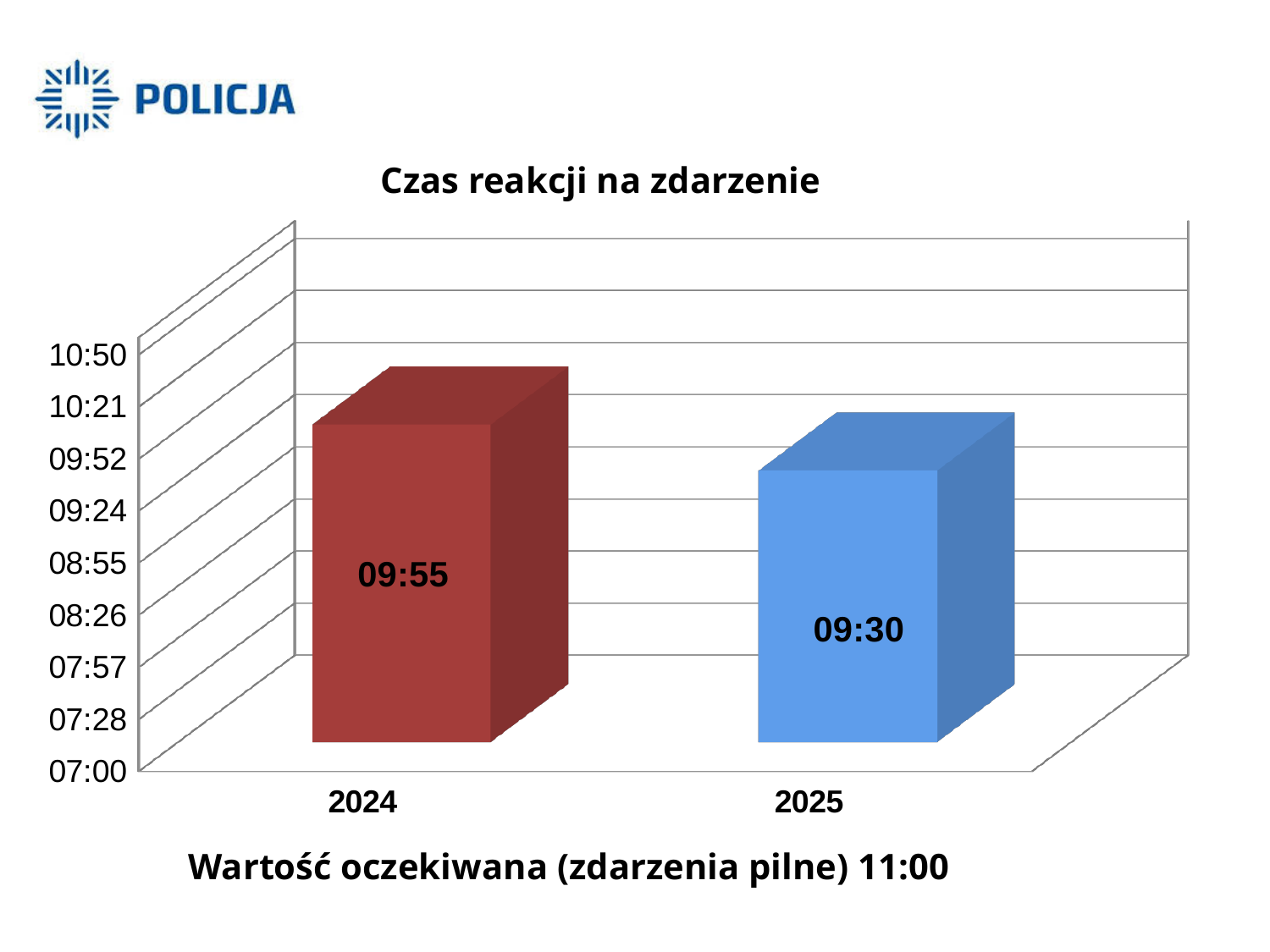
Which is larger, the value for 2024 or the value for 2025? 2024 What is the value for 2025 in the chart? 09:30 Is the value for 2024 greater or less than 09:24? greater What is the title of the chart? Czas reakcji na zdarzenie What kind of chart is shown on the slide? bar chart What is the difference between the values for 2024 and 2025? 00:25 Is the value for 2025 greater or less than 09:52? less Which year has the highest value in the chart? 2024 How many categories are shown in the chart? 2 Do the values rise or fall from 2024 to 2025? fall Which year has the lowest value in the chart? 2025 What is the value for 2024 in the chart? 09:55